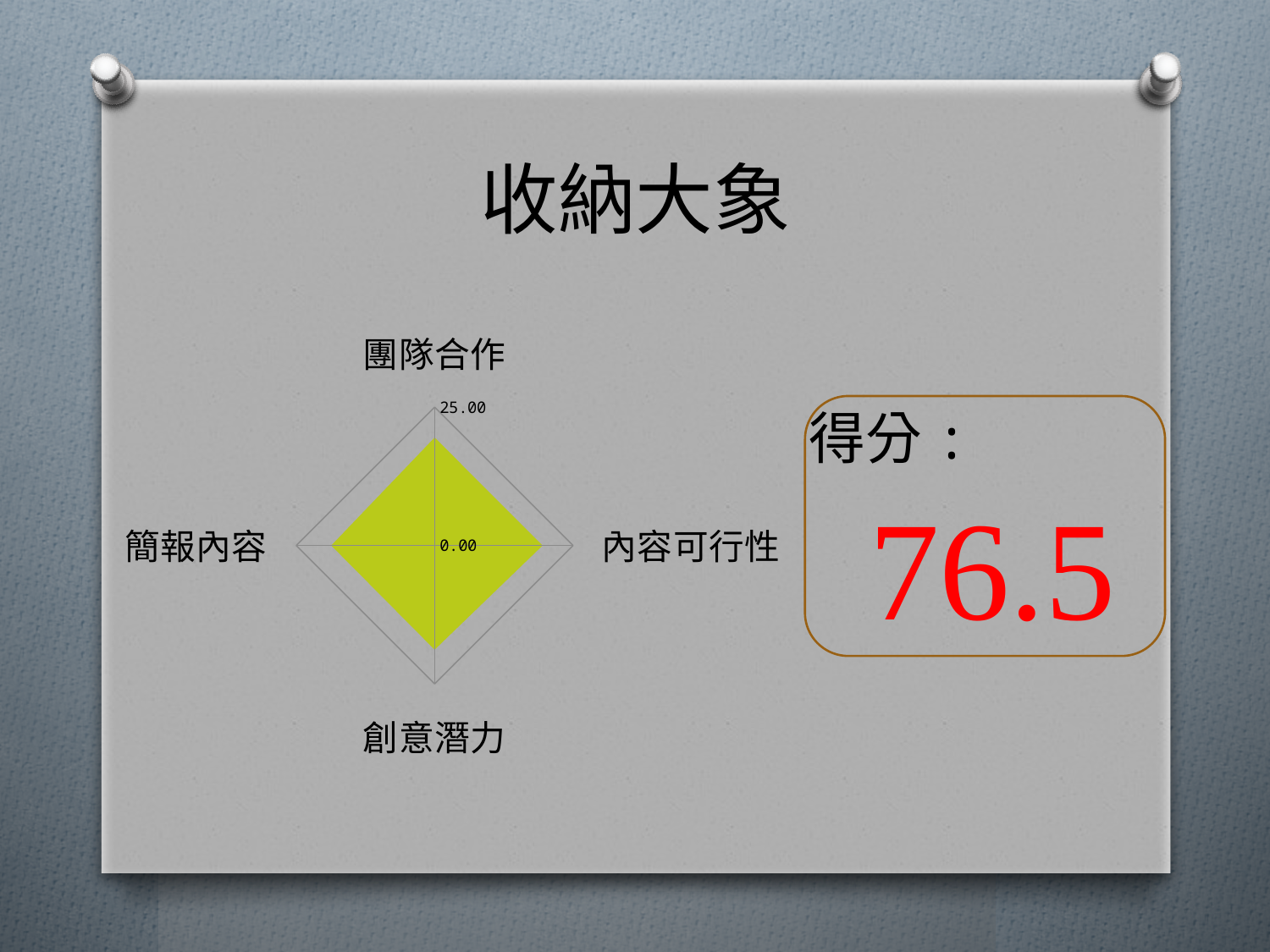
Is the value for 創意潛力 greater or less than 25.00? less Is the value for 團隊合作 greater or less than 25.00? less Which category is placed at the bottom of the radar chart? 創意潛力 Is the value for 簡報內容 greater or less than 0.00? greater How many categories (axes) does the radar chart have? 4 What is the lowest value shown on the radar chart's axis scale? 0.00 What kind of chart is shown on the slide? radar chart Which category is placed at the top of the radar chart? 團隊合作